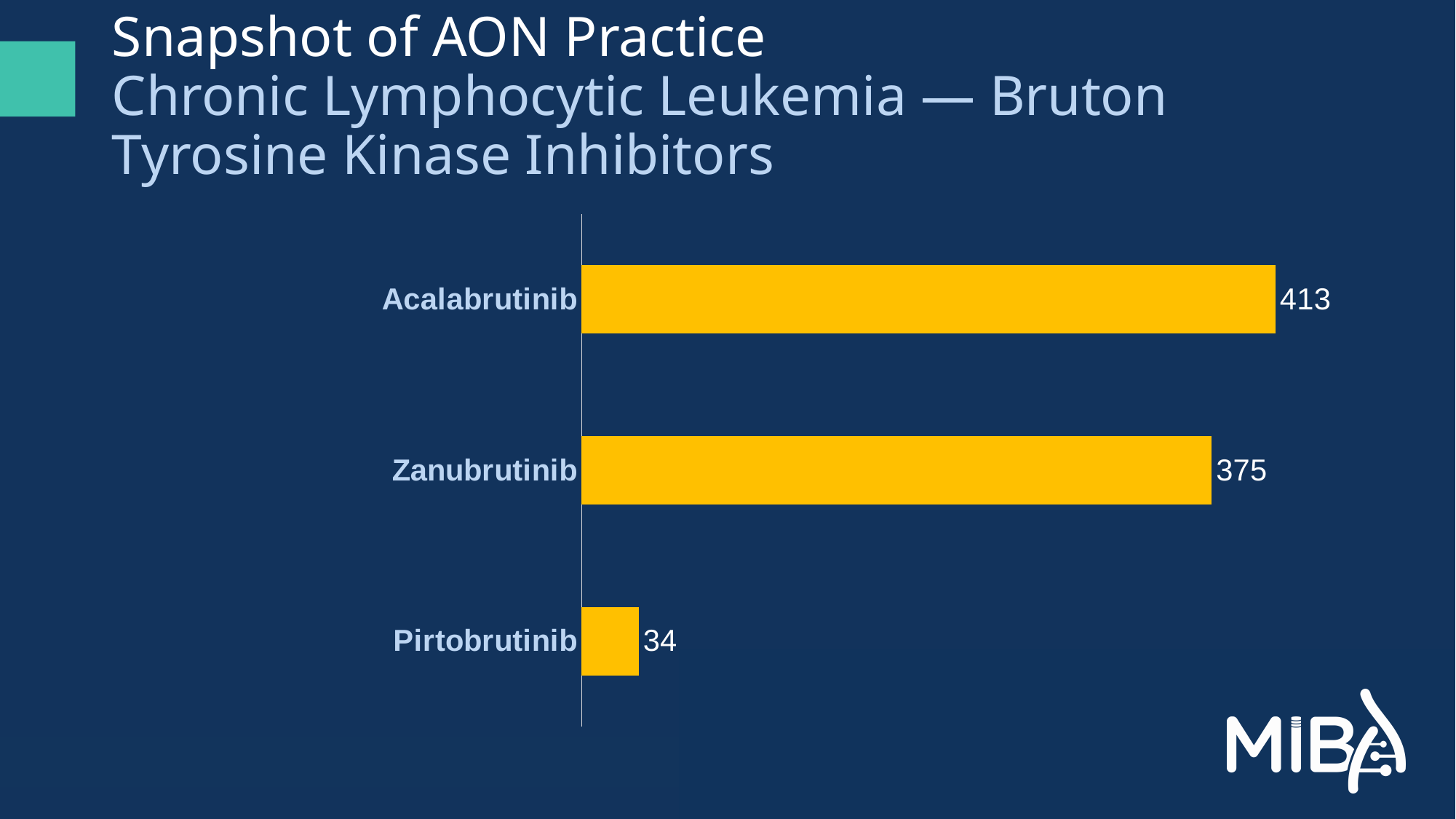
What is the difference between the values for Acalabrutinib and Zanubrutinib? 38 What is the value for Pirtobrutinib? 34 How many categories are shown in the chart? 3 What kind of chart is shown on the slide? Bar chart Which category has the lowest value? Pirtobrutinib What is the difference between the values for Zanubrutinib and Pirtobrutinib? 341 What is the value for Acalabrutinib? 413 Which is larger, the value for Acalabrutinib or the value for Zanubrutinib? Acalabrutinib What is the total of the three values shown in the chart? 822 What colour are the bars in the chart? Yellow What is the value for Zanubrutinib? 375 Which category has the highest value? Acalabrutinib